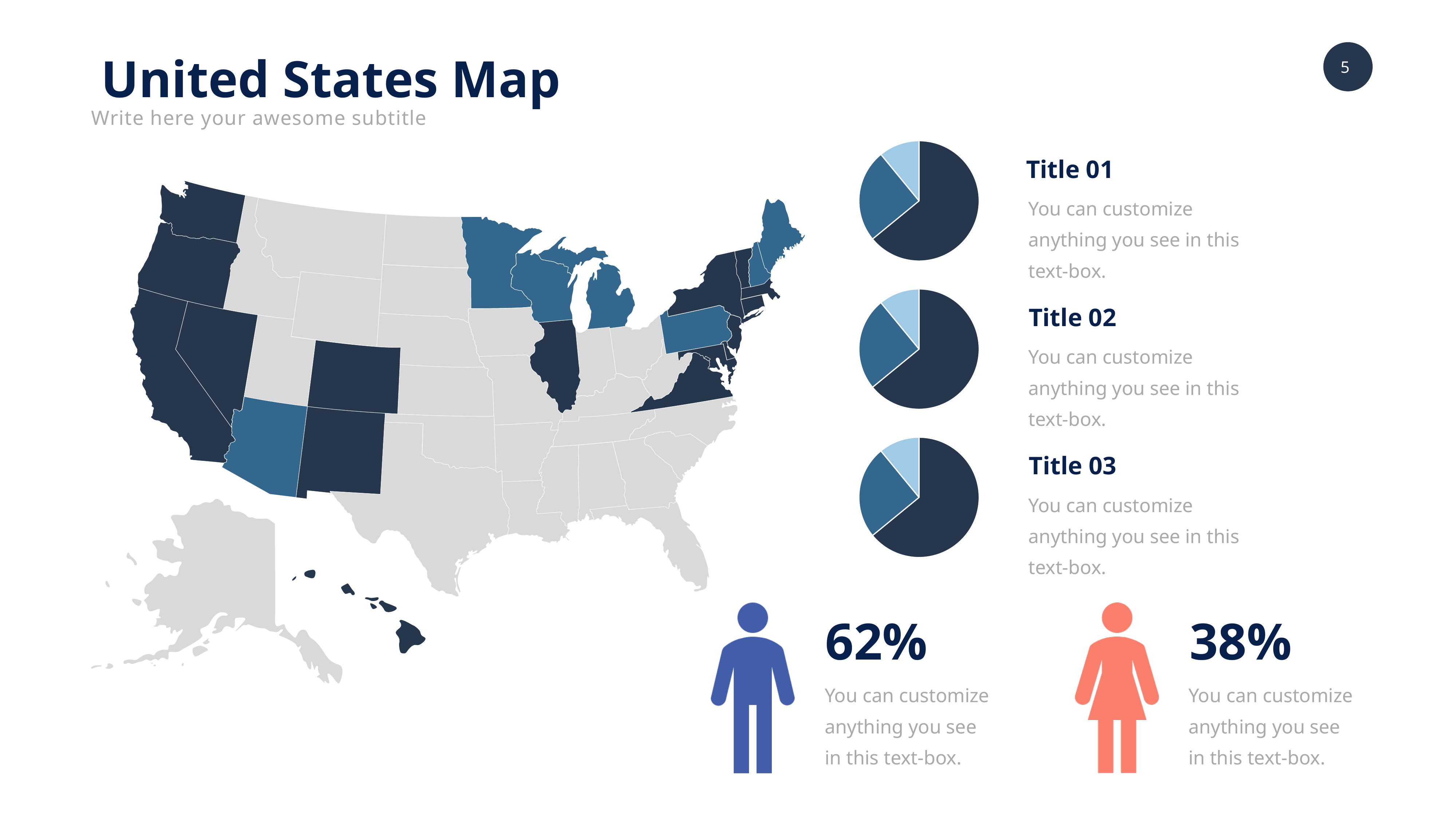
What is the difference between the percentage next to the male figure and the percentage next to the female figure? 24% How many slices does the pie chart next to Title 03 have? 3 Do the pie charts on the slide have a legend? No In the pie chart next to Title 01, does the dark navy slice take up more or less than half of the pie? more In the pie chart next to Title 02, which colour slice is the smallest? light blue What are the titles printed next to the three pie charts? Title 01, Title 02, Title 03 In the pie chart next to Title 01, which colour slice is the largest? dark navy How many slices does the pie chart next to Title 01 have? 3 In the pie chart next to Title 03, is the dark navy slice larger or smaller than the medium blue slice? larger What kind of chart is shown next to Title 01? pie chart How many pie charts are on the slide? 3 What percentage is shown next to the blue male figure at the bottom of the slide? 62%